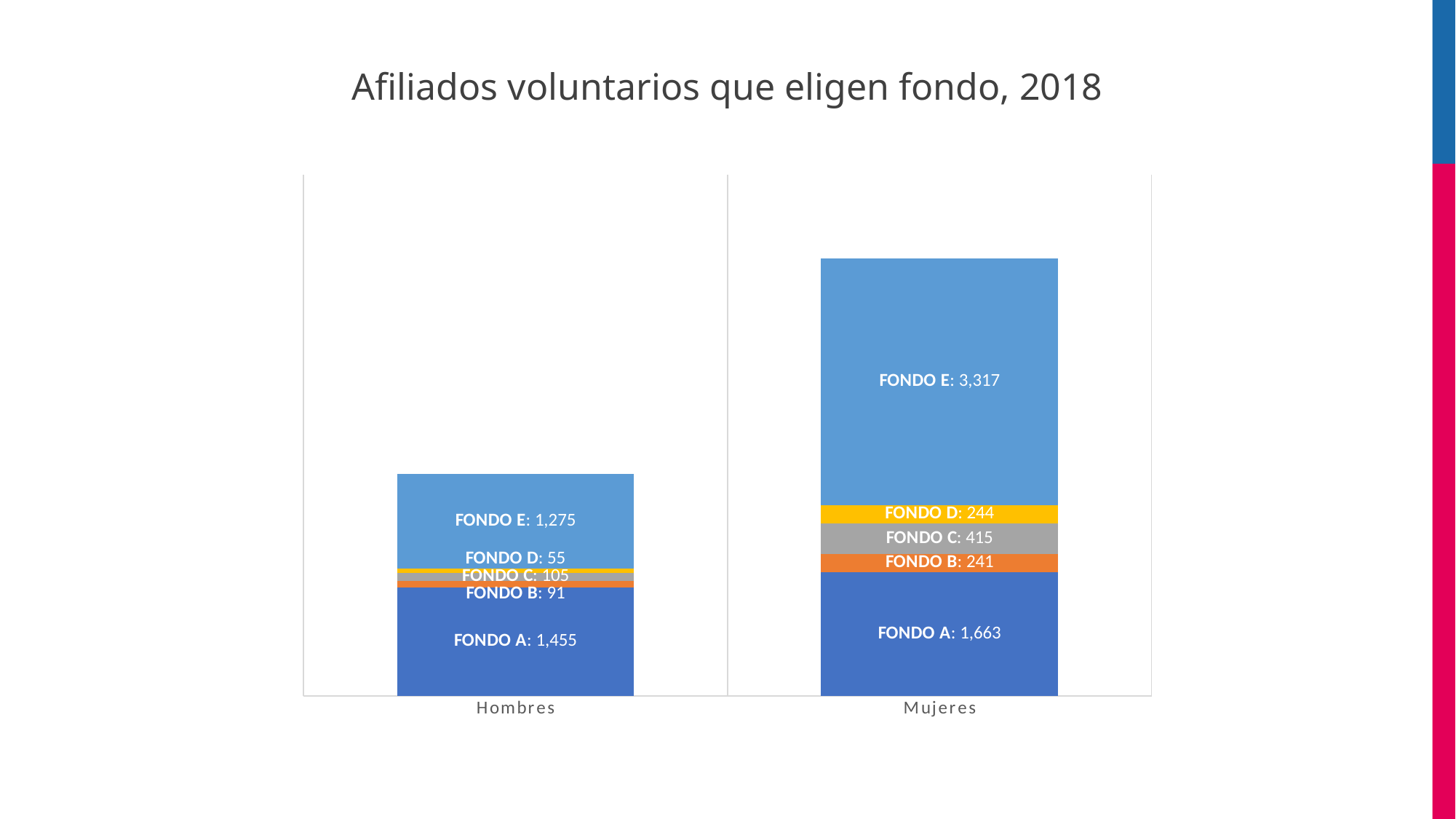
How many categories are shown on the x axis? 2 What is the difference between FONDO E for Mujeres and FONDO E for Hombres? 2,042 Which fondo has the largest value in the Mujeres bar? FONDO E What is the value for FONDO A in the Mujeres bar? 1,663 Which is larger: FONDO B for Hombres or FONDO B for Mujeres? FONDO B for Mujeres What is the total of the Mujeres stacked bar? 5,880 What is the value for FONDO C in the Mujeres bar? 415 Which fondo has the smallest value in the Hombres bar? FONDO D What type of chart is shown on the slide? Stacked bar chart What is the value for FONDO E in the Hombres bar? 1,275 What is the total of the Hombres stacked bar? 2,981 What is the value for FONDO D in the Hombres bar? 55